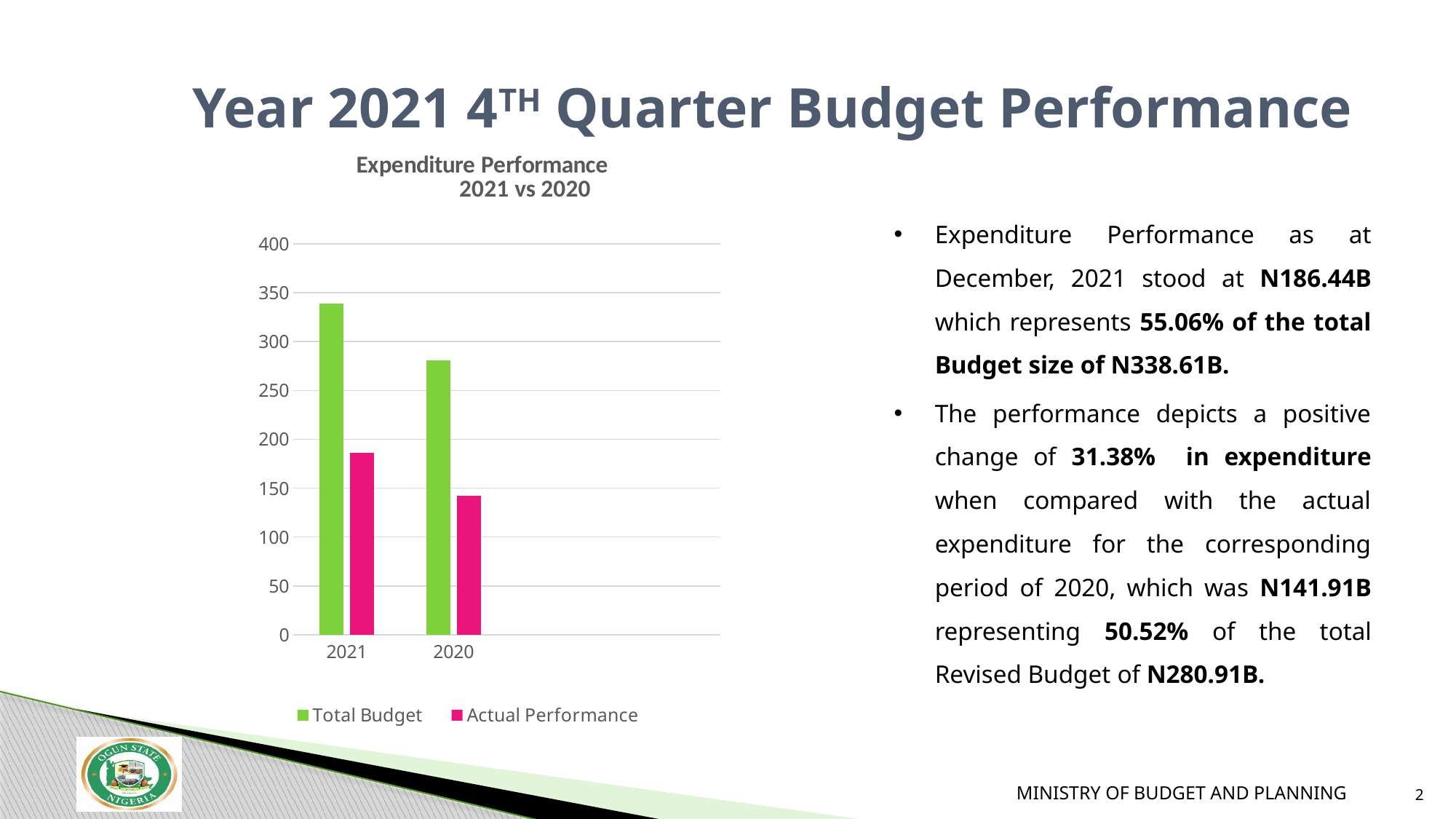
What kind of chart is shown on the slide? bar chart Is the Actual Performance value for 2020 greater or less than 150? less Which bar is the lowest in the chart? Actual Performance for 2020 How many year categories are shown on the x axis of the chart? 2 Is the Total Budget value for 2021 greater or less than 300? greater Is the Total Budget value for 2020 greater or less than 300? less Which bar is the highest in the chart? Total Budget for 2021 What is the title of the chart? Expenditure Performance 2021 vs 2020 How many series does the chart legend list? 2 Which series is shown in green in the chart? Total Budget Which year has the higher Total Budget bar, 2021 or 2020? 2021